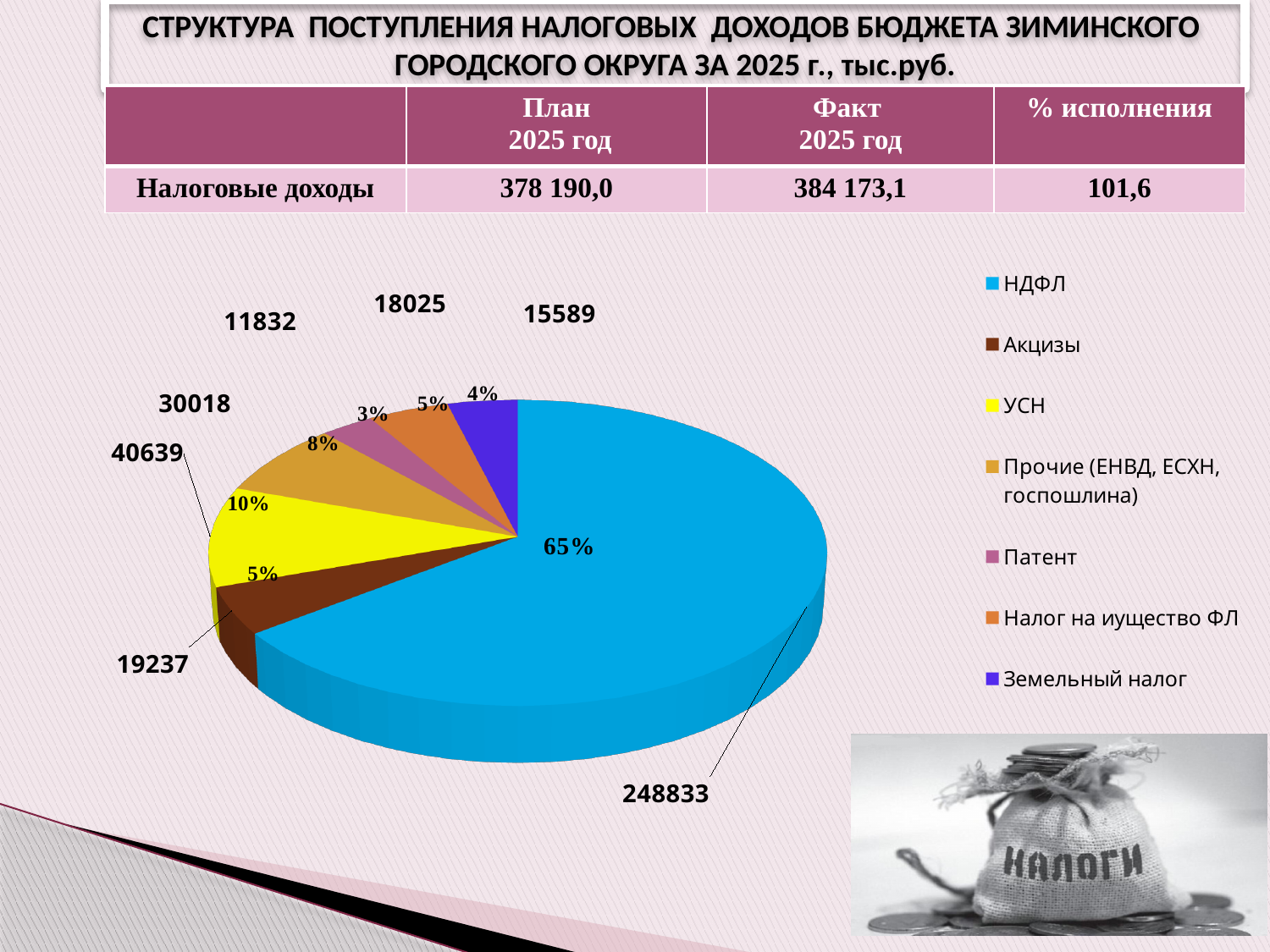
What is the value shown for Патент in the pie chart? 11832 Which category has the largest slice in the pie chart? НДФЛ How many entries does the legend of the pie chart list? 7 Which category has the smallest slice in the pie chart? Патент What share of the pie does НДФЛ account for? 65% Which is larger in the pie chart: УСН or Прочие (ЕНВД, ЕСХН, госпошлина)? УСН What is the value shown for УСН in the pie chart? 40639 What kind of chart is shown on the slide? pie chart What is the value shown for НДФЛ in the pie chart? 248833 What is the difference between the values for УСН and Прочие (ЕНВД, ЕСХН, госпошлина)? 10621 How many slices does the pie chart have? 7 What share of the pie does Прочие (ЕНВД, ЕСХН, госпошлина) account for? 8%